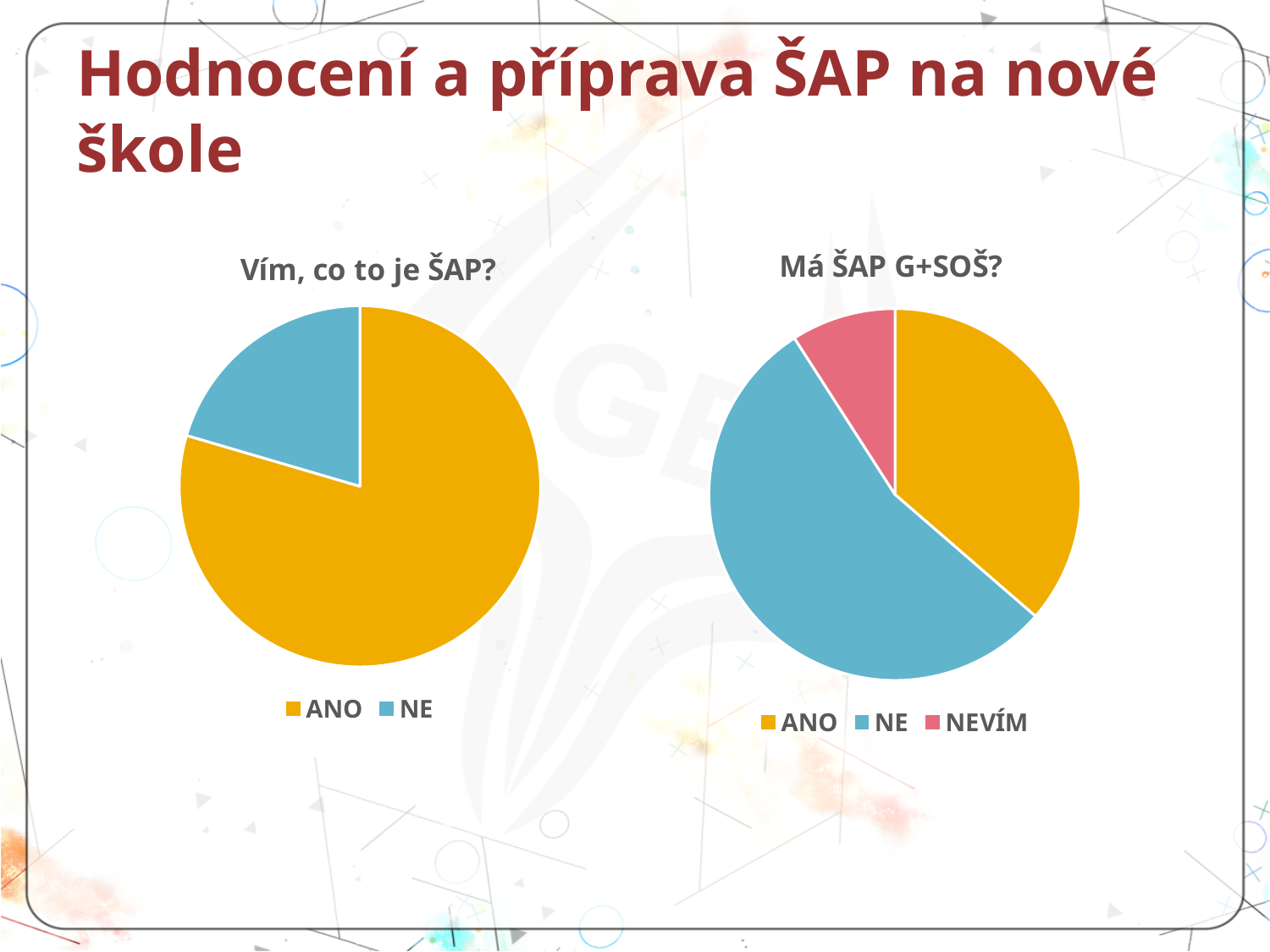
In the chart titled "Vím, co to je ŠAP?", how many slices does the pie have? 2 In the chart titled "Má ŠAP G+SOŠ?", which slice is larger, ANO or NEVÍM? ANO In the chart titled "Má ŠAP G+SOŠ?", how many slices does the pie have? 3 In the chart titled "Vím, co to je ŠAP?", which slice is the largest? ANO What kind of chart is the chart titled "Vím, co to je ŠAP?"? pie chart In the chart titled "Má ŠAP G+SOŠ?", how many entries does the legend list? 3 What kind of chart is the chart titled "Má ŠAP G+SOŠ?"? pie chart In the chart titled "Má ŠAP G+SOŠ?", which slice is the largest? NE In the chart titled "Vím, co to je ŠAP?", which slice is the smallest? NE In the chart titled "Má ŠAP G+SOŠ?", what colour is the NEVÍM slice? pink/red In the chart titled "Má ŠAP G+SOŠ?", which slice is the smallest? NEVÍM In the chart titled "Vím, co to je ŠAP?", how many entries does the legend list? 2